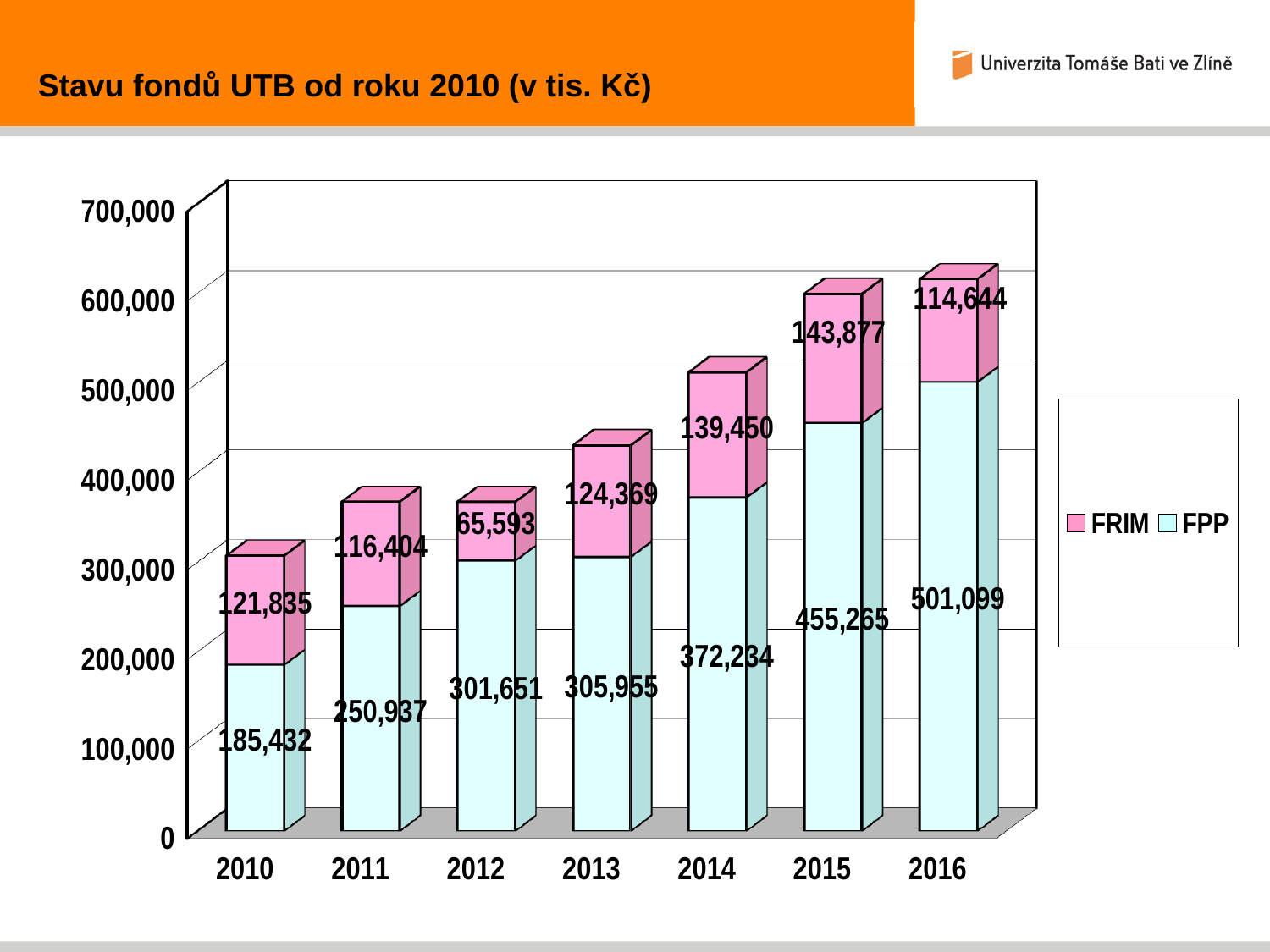
What is the total of the stacked bar for 2016? 615,743 How many series does the legend list? 2 Which is larger, the FRIM value for 2013 or the FRIM value for 2011? 2013 What is the difference between the FPP values for 2016 and 2010? 315,667 Which year has the lowest FRIM value? 2012 Do the FPP values rise or fall from 2010 to 2016? Rise What kind of chart is shown on the slide? Stacked bar chart What is the total of the stacked bar for 2010? 307,267 What is the FPP value for 2014? 372,234 What is the FRIM value for 2012? 65,593 How many years are shown on the x axis? 7 Which year has the highest FPP value? 2016